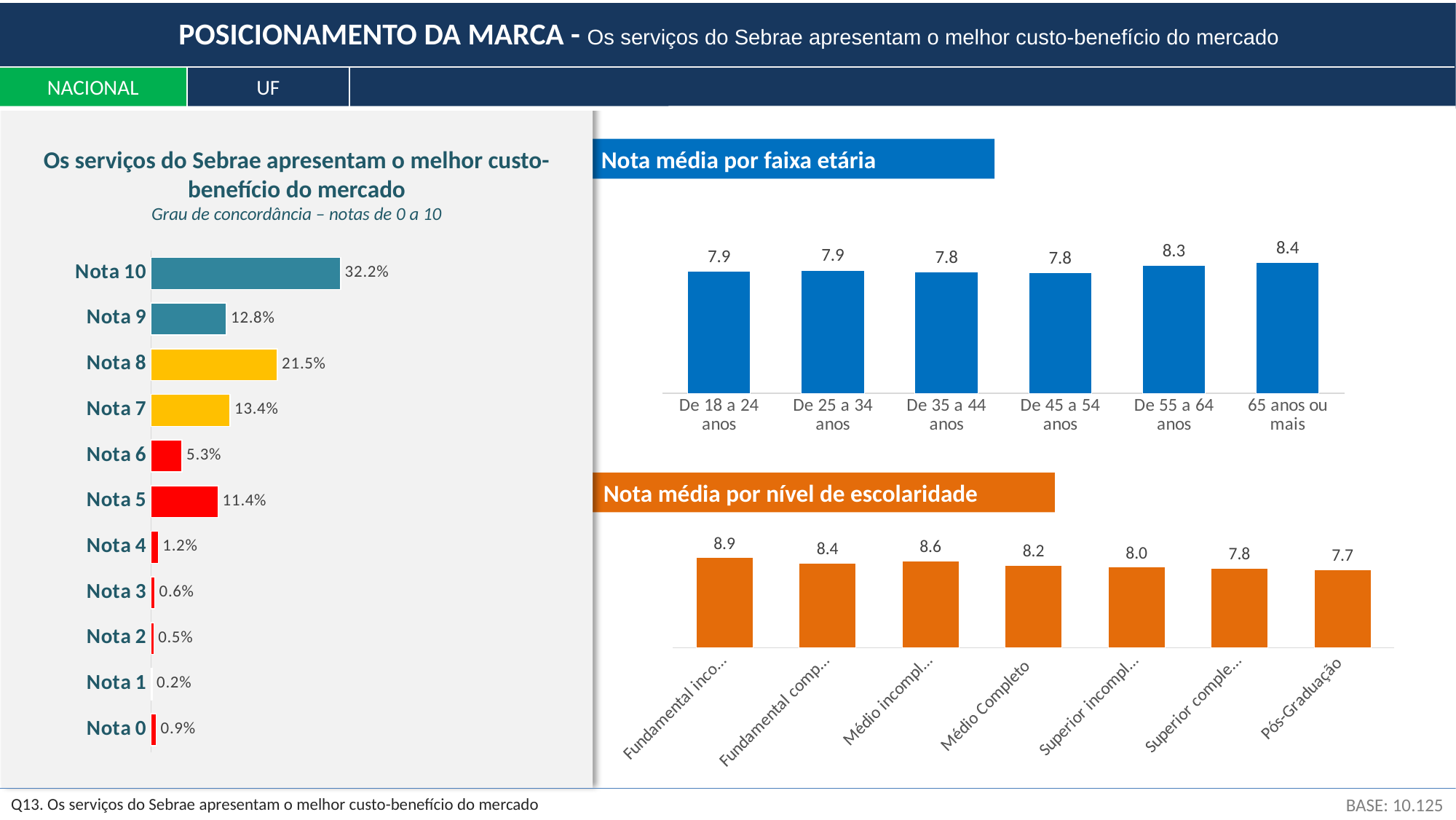
In the chart 'Os serviços do Sebrae apresentam o melhor custo-benefício do mercado', how many notas are listed? 11 In the chart 'Os serviços do Sebrae apresentam o melhor custo-benefício do mercado', which nota has the lowest percentage? Nota 1 In the chart 'Nota média por nível de escolaridade', what is the value for 'Médio Completo'? 8.2 What type of chart is 'Os serviços do Sebrae apresentam o melhor custo-benefício do mercado'? Bar chart In the chart 'Os serviços do Sebrae apresentam o melhor custo-benefício do mercado', what percentage is shown for Nota 10? 32.2% In the chart 'Os serviços do Sebrae apresentam o melhor custo-benefício do mercado', what percentage is shown for Nota 5? 11.4% In the chart 'Nota média por nível de escolaridade', which education level has the lowest average score? Pós-Graduação In the chart 'Nota média por faixa etária', what is the value for 'De 55 a 64 anos'? 8.3 In the chart 'Os serviços do Sebrae apresentam o melhor custo-benefício do mercado', what is the difference between the percentages for Nota 8 and Nota 7? 8.1% In the chart 'Nota média por faixa etária', how many age groups are shown? 6 In the chart 'Nota média por nível de escolaridade', what is the difference between the highest value (8.9) and the value for Pós-Graduação? 1.2 In the chart 'Nota média por faixa etária', which age group has the highest average score? 65 anos ou mais